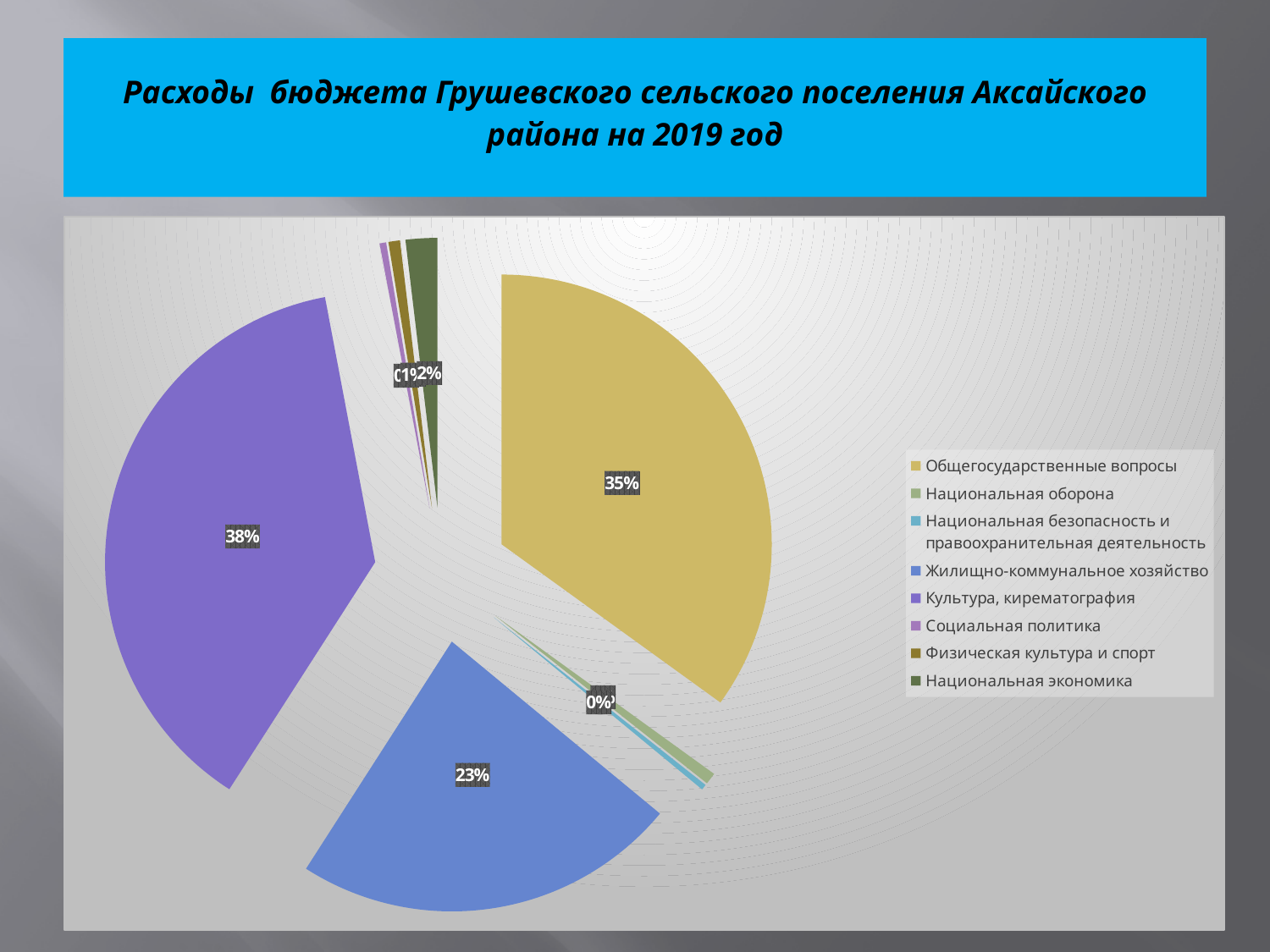
What is the title of the slide? Расходы бюджета Грушевского сельского поселения Аксайского района на 2019 год What share of the budget expenses goes to Жилищно-коммунальное хозяйство? 23% What colour is the slice for Общегосударственные вопросы? Yellow (gold) Which category has the largest share of the budget expenses? Культура, кирематография What share of the budget expenses goes to Культура, кинематография? 38% By how many percentage points does the share for Культура, кинематография exceed the share for Общегосударственные вопросы? 3 percentage points How many categories does the legend of the pie chart list? 8 Which is larger: the share for Культура, кинематография or the share for Жилищно-коммунальное хозяйство? Культура, кирематография Which is larger: the share for Общегосударственные вопросы or the share for Жилищно-коммунальное хозяйство? Общегосударственные вопросы What share of the budget expenses goes to Общегосударственные вопросы? 35% By how many percentage points does the share for Общегосударственные вопросы exceed the share for Жилищно-коммунальное хозяйство? 12 percentage points What kind of chart is shown on the slide? Pie chart